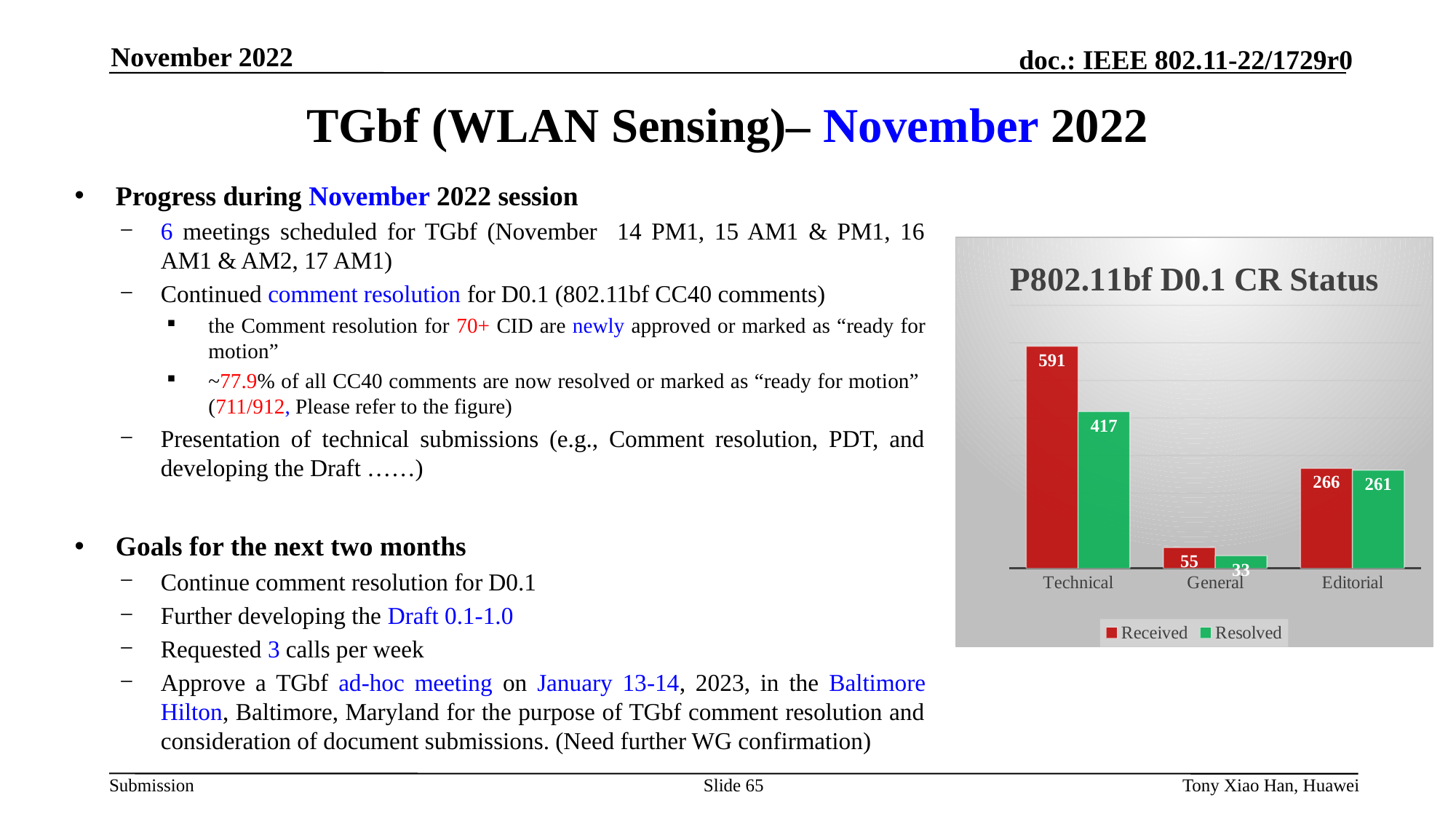
How many series does the legend list? 2 What is the difference between Received and Resolved for Editorial? 5 What is the Received value for Technical? 591 How many categories are shown on the x axis? 3 Which category has the lowest Resolved value? General What is the title of the chart? P802.11bf D0.1 CR Status Which is larger, the Received value for General or the Resolved value for General? Received What kind of chart is shown? Bar chart What is the Resolved value for Editorial? 261 Which category has the highest Received value? Technical What is the difference between Received and Resolved for Technical? 174 What is the Resolved value for General? 33